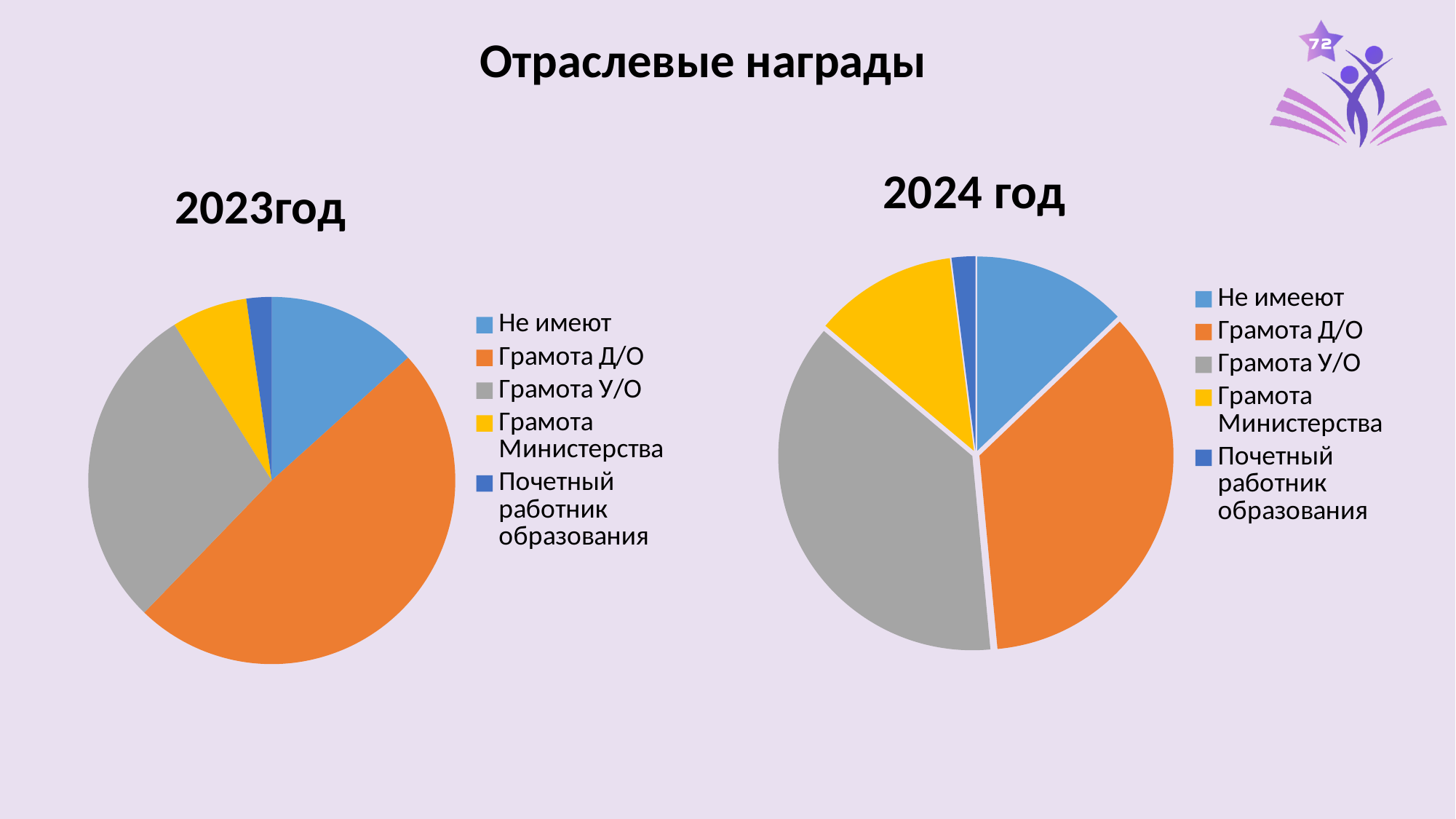
In the 2023 год pie chart, which category has the largest slice? Грамота Д/О In the 2024 год pie chart, which category has the smallest slice? Почетный работник образования What kind of chart is used for the 2023 год data? pie chart In the 2023 год pie chart, which slice is larger: Грамота Министерства or Почетный работник образования? Грамота Министерства How many entries does the legend of the 2024 год chart list? 5 In the 2024 год pie chart, which slice is larger: Грамота У/О or Грамота Министерства? Грамота У/О What is the title of the slide containing the two pie charts? Отраслевые награды In the 2023 год pie chart, which slice is larger: Грамота У/О or Не имеют? Грамота У/О How many slices does the 2023 год pie chart have? 5 In the 2023 год pie chart, which category has the smallest slice? Почетный работник образования Which colour represents Грамота Министерства in the 2023 год pie chart? yellow